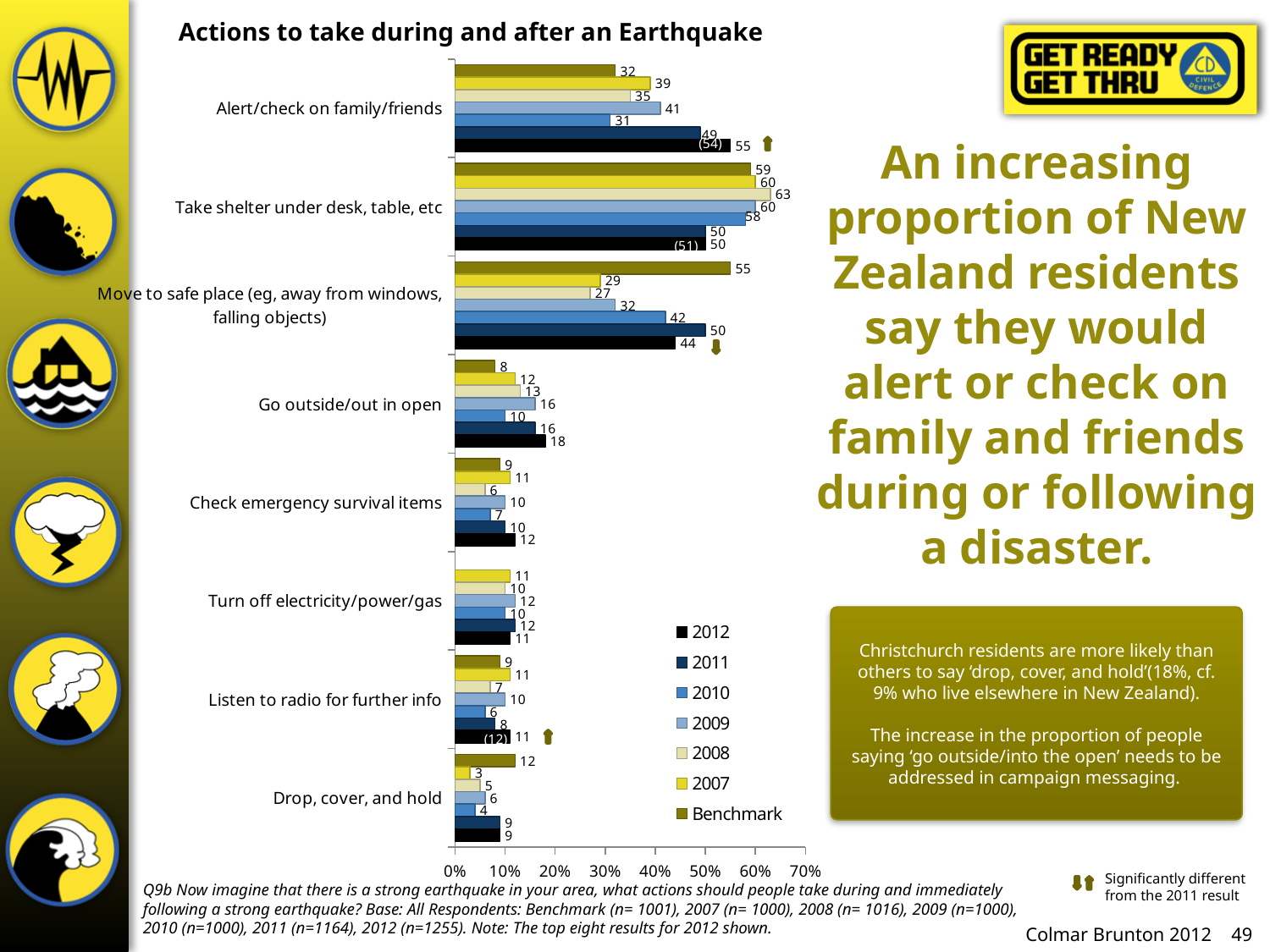
What is the 2012 value for Alert/check on family/friends? 55 What kind of chart is shown on the slide? Bar chart Which is larger: the 2010 value for Move to safe place or the 2010 value for Alert/check on family/friends? Move to safe place How many actions (categories) are shown in the chart? 8 Which action has the highest 2012 value? Alert/check on family/friends What is the 2012 value for Go outside/out in open? 18 Which action has the lowest 2012 value? Drop, cover, and hold How many series does the legend list? 7 What is the difference between the 2012 and 2011 values for Alert/check on family/friends? 6 What is the 2008 value for Take shelter under desk, table, etc? 63 What is the Benchmark value for Move to safe place (eg, away from windows, falling objects)? 55 What is the title of the chart? Actions to take during and after an Earthquake